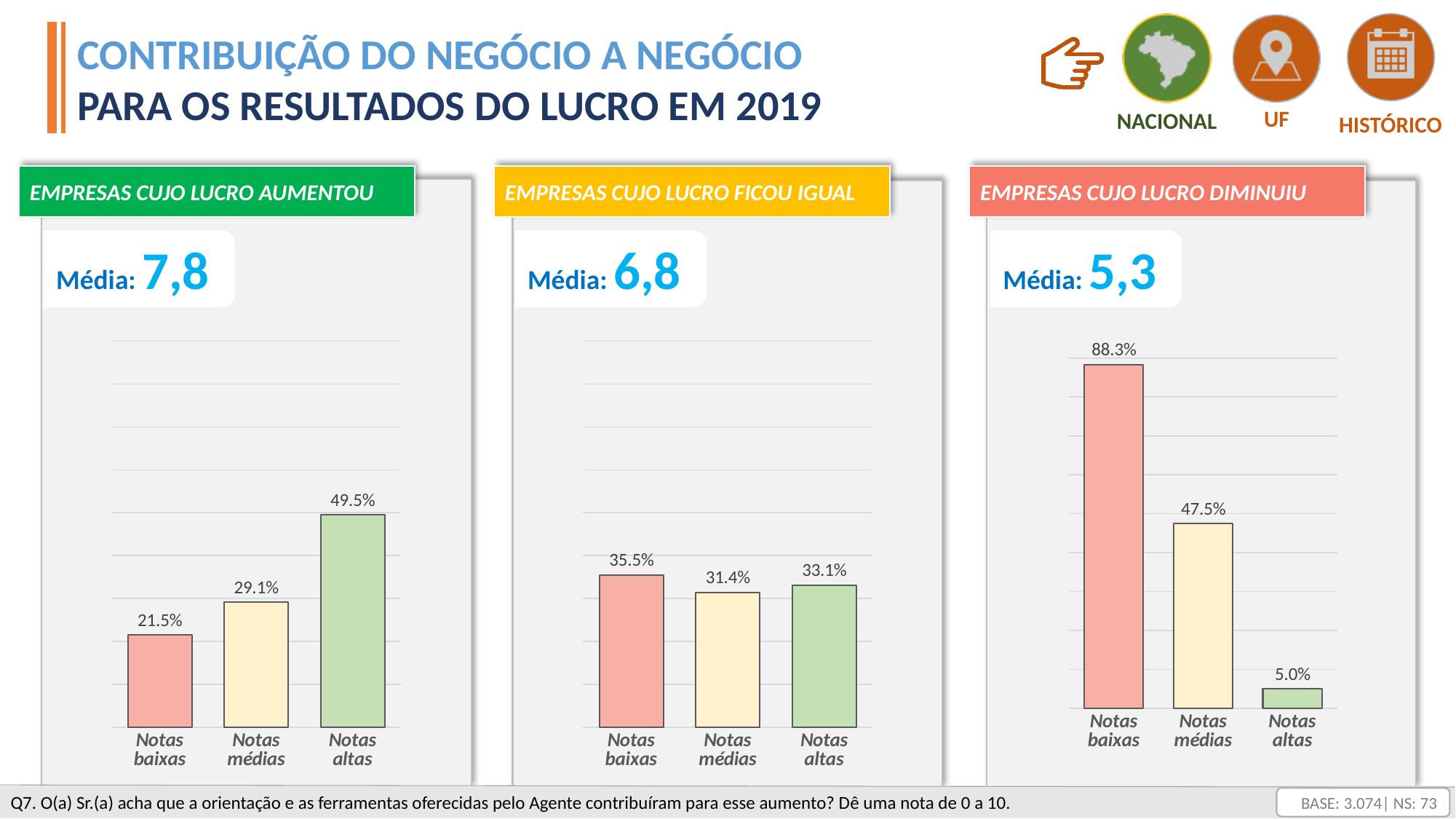
In the chart 'EMPRESAS CUJO LUCRO FICOU IGUAL', which category has the highest value? Notas baixas What kind of chart is 'EMPRESAS CUJO LUCRO AUMENTOU'? Bar chart In the chart 'EMPRESAS CUJO LUCRO FICOU IGUAL', what is the value for Notas médias? 31.4% In the chart 'EMPRESAS CUJO LUCRO AUMENTOU', which category has the highest value? Notas altas In the chart 'EMPRESAS CUJO LUCRO FICOU IGUAL', which is larger: Notas baixas or Notas altas? Notas baixas In the chart 'EMPRESAS CUJO LUCRO AUMENTOU', what is the difference between Notas altas and Notas baixas? 28.0% In the chart 'EMPRESAS CUJO LUCRO AUMENTOU', what is the value for Notas altas? 49.5% How many categories are shown in the chart 'EMPRESAS CUJO LUCRO DIMINUIU'? 3 What is the Média shown for the chart 'EMPRESAS CUJO LUCRO DIMINUIU'? 5,3 In the chart 'EMPRESAS CUJO LUCRO DIMINUIU', which category has the lowest value? Notas altas In the chart 'EMPRESAS CUJO LUCRO DIMINUIU', what is the value for Notas baixas? 88.3% In the chart 'EMPRESAS CUJO LUCRO DIMINUIU', what is the difference between Notas baixas and Notas médias? 40.8%